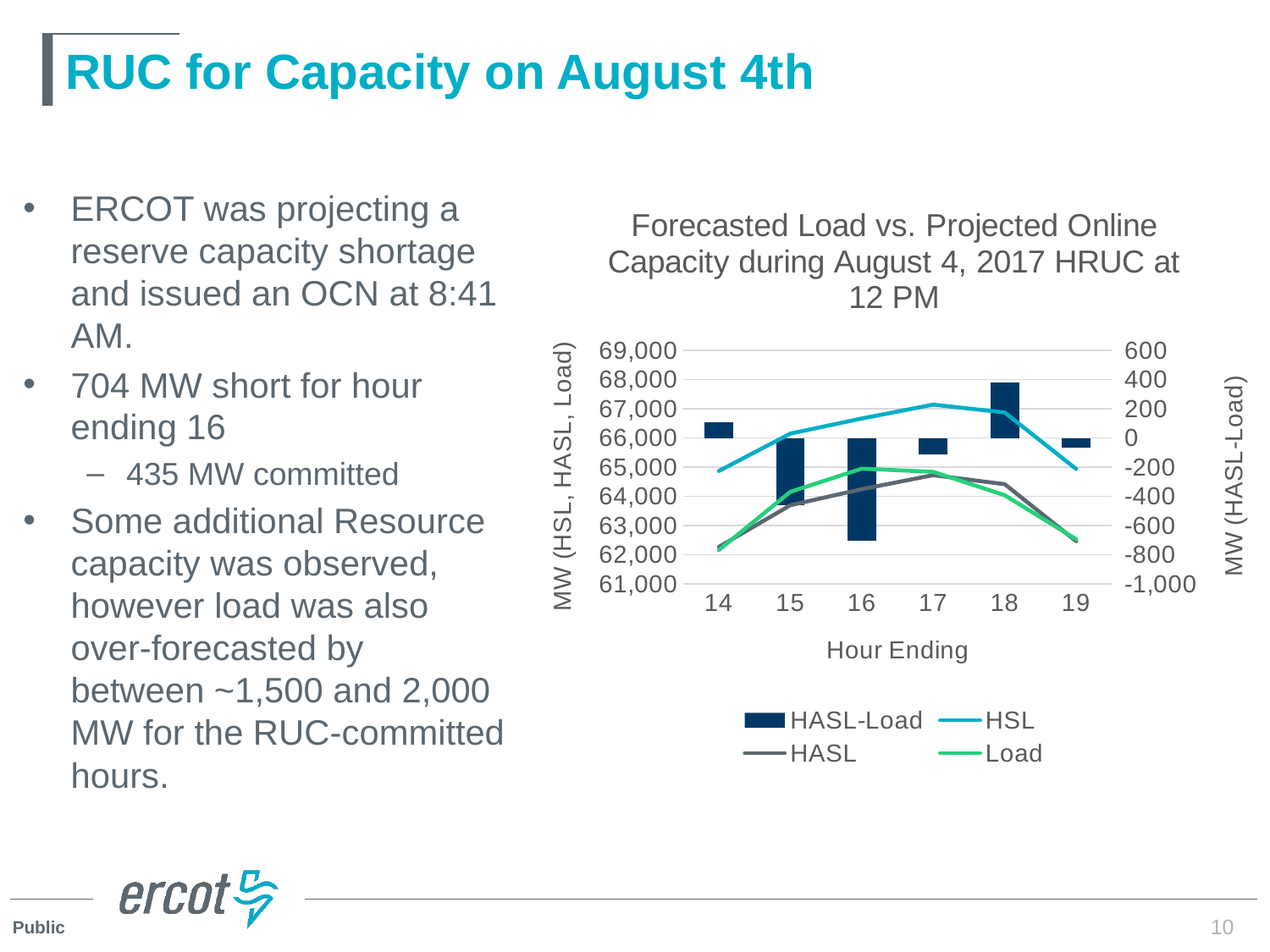
At hour ending 15, which is higher, HASL or Load? Load At which hour ending is the HASL-Load bar the largest positive value? 18 Is the HASL-Load value at hour ending 18 greater or less than 200? greater Is the HSL value at hour ending 16 greater or less than 66,000? greater At which hour ending is the HASL-Load bar the most negative? 16 Does the Load line rise or fall from hour ending 14 to hour ending 16? rise How many series does the chart's legend list? 4 Which series in the chart is plotted as bars rather than a line? HASL-Load How many hour-ending categories are shown on the x axis of the chart? 6 What kind of chart is shown on the slide? A combined bar and line chart What is the title of the chart? Forecasted Load vs. Projected Online Capacity during August 4, 2017 HRUC at 12 PM Is the Load value at hour ending 14 greater or less than 63,000? less